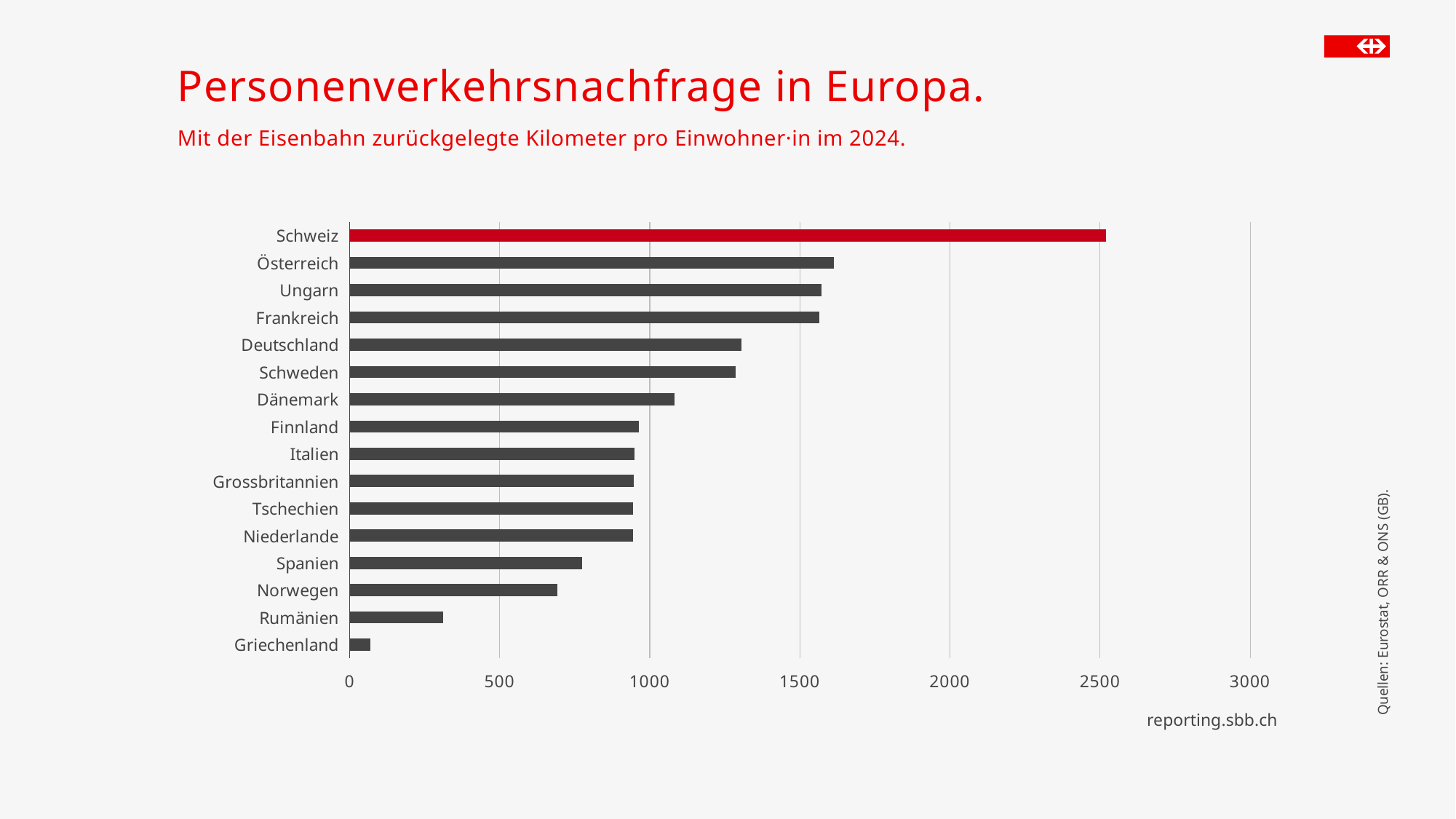
Which country has the highest value in the chart? Schweiz Which has the larger value, Spanien or Norwegen? Spanien Which country has the lowest value in the chart? Griechenland Is the value for Norwegen greater or less than 500? greater Is the value for Finnland greater or less than 1000? less Is the value for Österreich greater or less than 1500? greater Which has the larger value, Schweiz or Österreich? Schweiz What kind of chart is shown on the slide? Bar chart How many countries are shown in the chart? 16 Which bar is highlighted in red in the chart? Schweiz